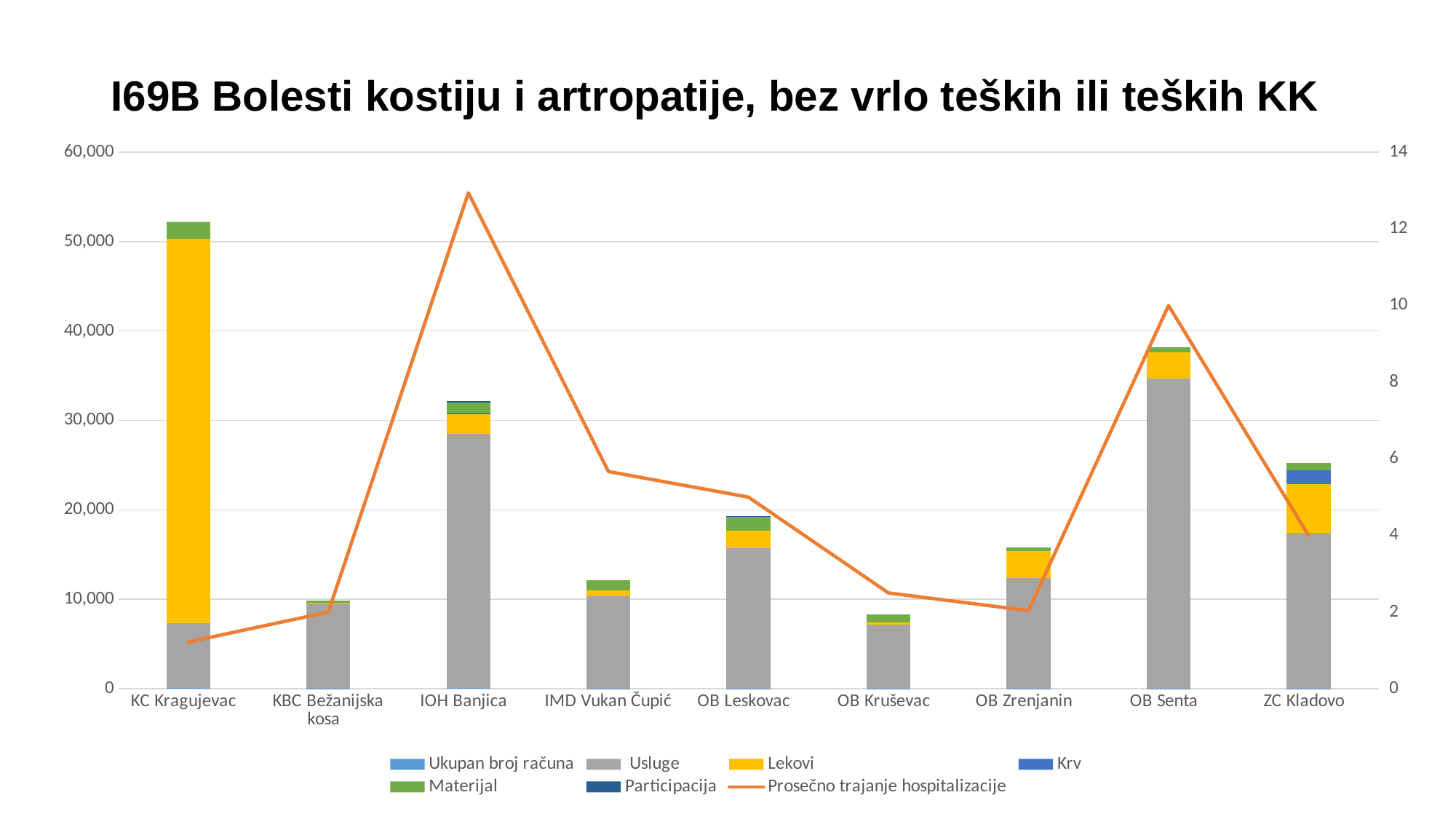
Is the total stacked bar for OB Senta greater or less than 40,000? less How many series does the legend list? 7 Which has the taller stacked bar, OB Leskovac or OB Zrenjanin? OB Leskovac Which hospital has the lowest value on the Prosečno trajanje hospitalizacije line? KC Kragujevac What is the title of the chart? I69B Bolesti kostiju i artropatije, bez vrlo teških ili teških KK How many hospitals (categories) are shown on the x axis? 9 Is the total stacked bar for KC Kragujevac greater or less than 50,000? greater Which hospital has the shortest stacked bar? OB Kruševac What kind of chart is this? Stacked bar chart with a line Which hospital has the tallest stacked bar? KC Kragujevac Is the Prosečno trajanje hospitalizacije value for IOH Banjica greater or less than 12? greater Which hospital has the highest value on the Prosečno trajanje hospitalizacije line? IOH Banjica